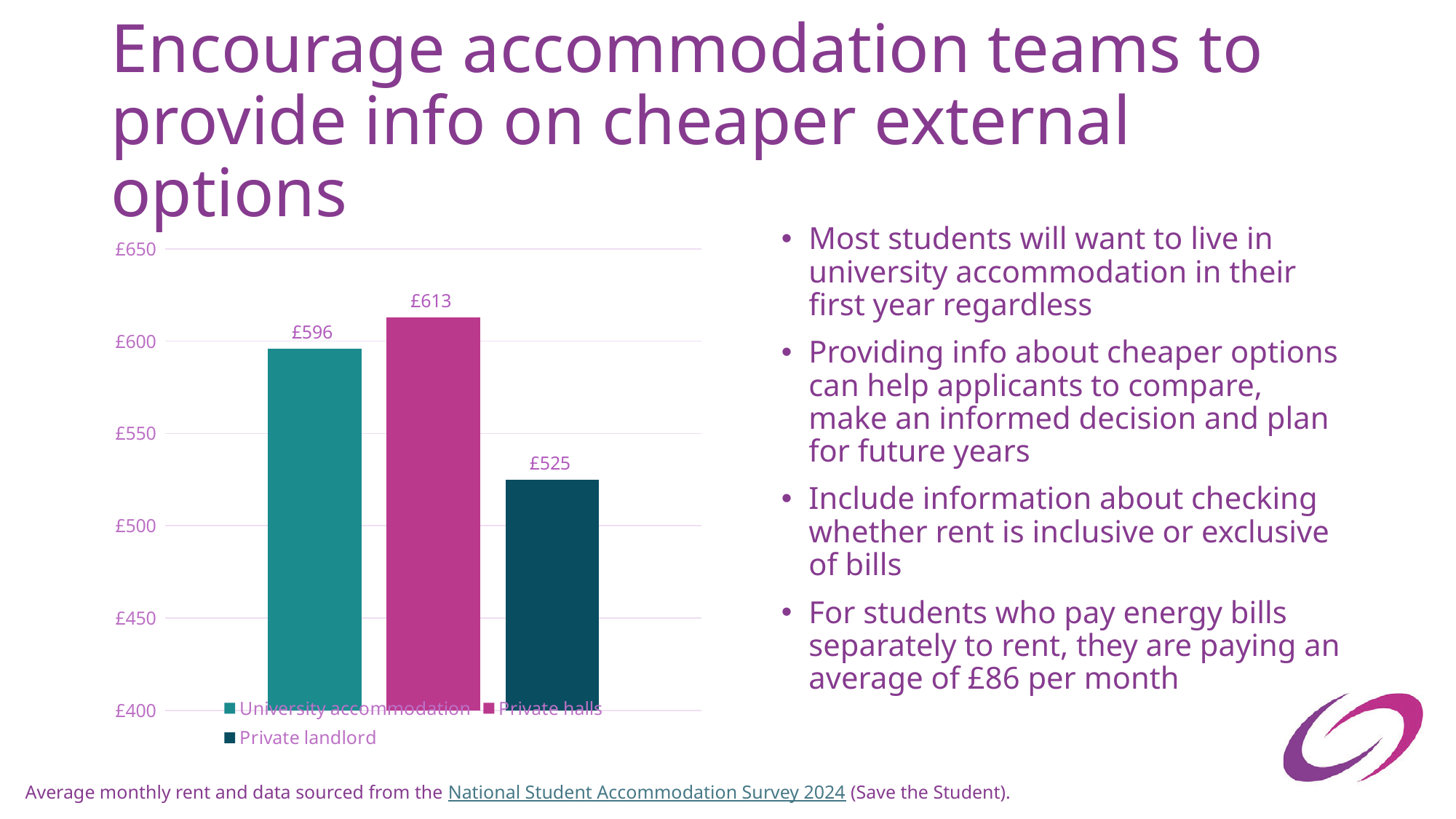
Which accommodation type has the lowest average monthly rent? Private landlord Is the value for Private landlord greater or less than £550? less Which accommodation type has the highest average monthly rent? Private halls How many entries does the chart legend list? 3 What kind of chart is shown on the slide? Bar chart What is the average monthly rent for Private landlord? £525 What is the difference between the rent for Private halls and the rent for University accommodation? £17 What is the average monthly rent for University accommodation? £596 What is the average monthly rent for Private halls? £613 Which is larger, the rent for University accommodation or the rent for Private landlord? University accommodation What is the difference between the rent for Private halls and the rent for Private landlord? £88 How many bars are shown in the chart? 3